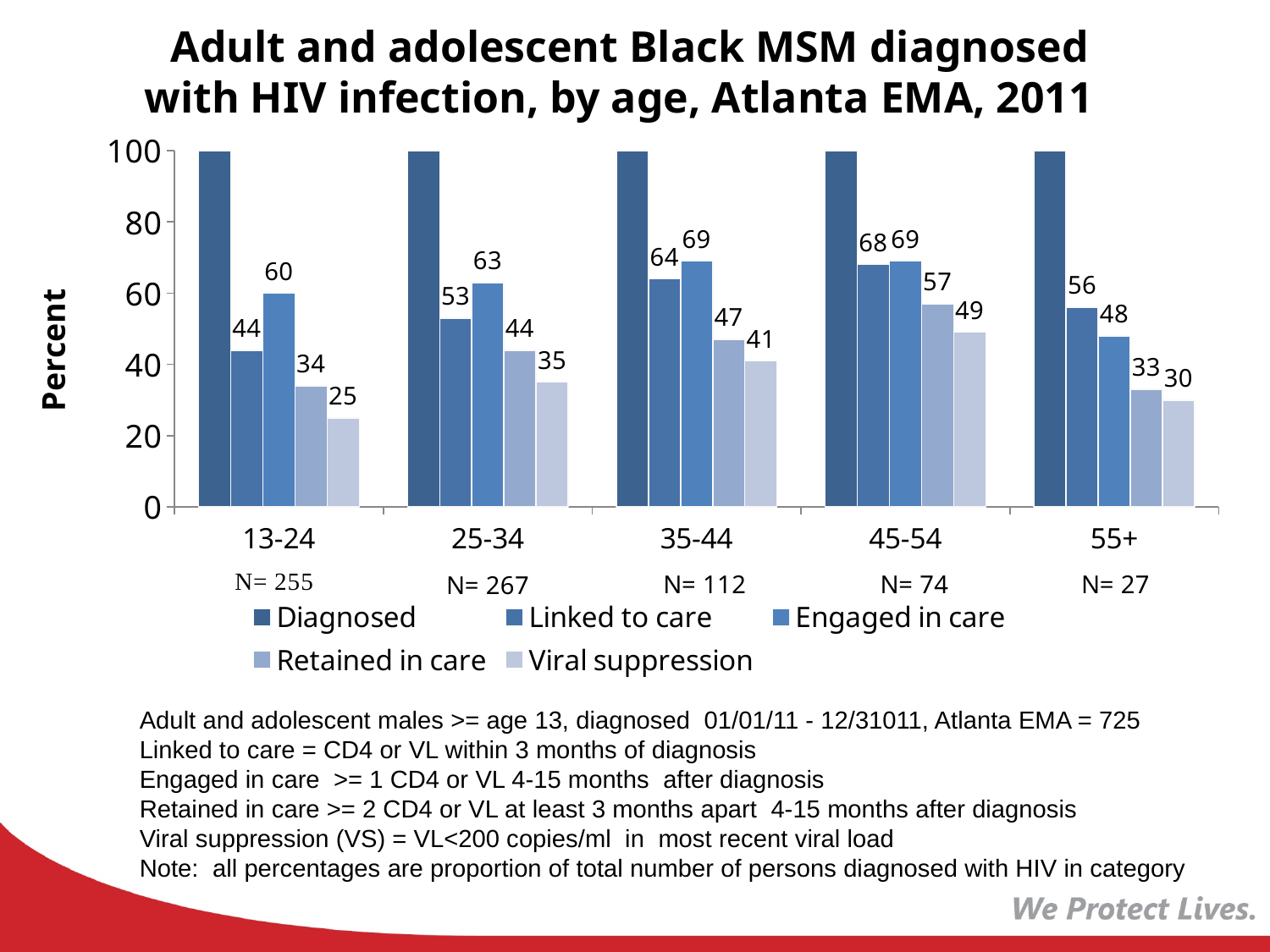
How many age groups are shown on the x axis? 5 Is the Diagnosed value for the 25-34 age group greater or less than 80? greater What is the Retained in care value for the 35-44 age group? 47 What is the Linked to care value for the 45-54 age group? 68 What is the N shown for the 55+ age group? N= 27 Which age group has the lowest Linked to care value? 13-24 What is the Viral suppression value for the 13-24 age group? 25 What is the difference between the Engaged in care and Viral suppression values for the 25-34 age group? 28 How many series does the legend list? 5 Which age group has the highest Viral suppression value? 45-54 What kind of chart is shown on the slide? bar chart Is the Engaged in care value larger for the 35-44 age group or the 55+ age group? 35-44